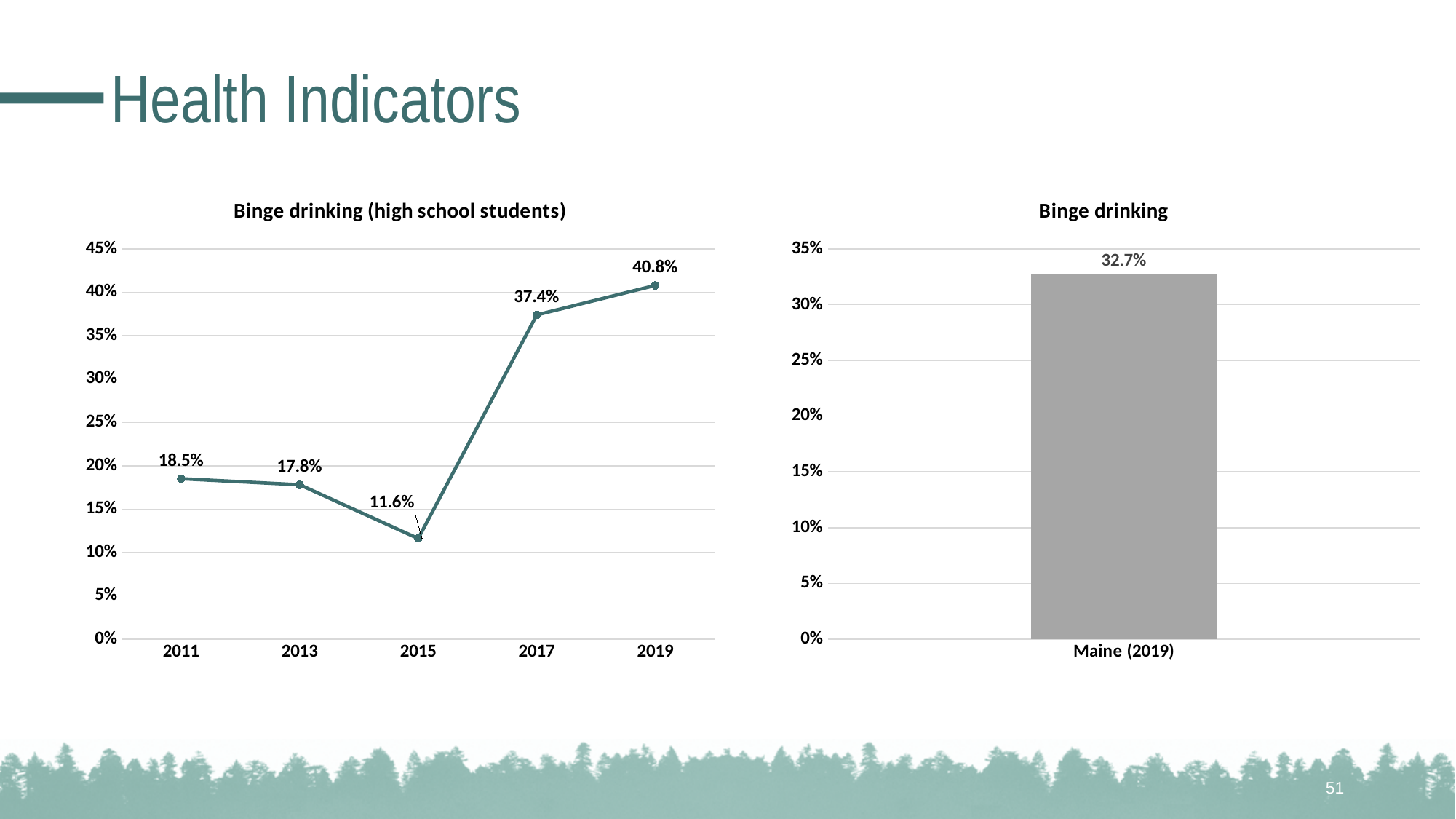
What kind of chart is the 'Binge drinking' chart on the right? Bar chart In the 'Binge drinking (high school students)' chart, which is larger, the value for 2011 or the value for 2013? 2011 What kind of chart is the 'Binge drinking (high school students)' chart? Line chart In the 'Binge drinking (high school students)' chart, how many years are plotted? 5 In the 'Binge drinking (high school students)' chart, which year has the highest value? 2019 In the 'Binge drinking' chart on the right, what is the value for Maine (2019)? 32.7% In the 'Binge drinking (high school students)' chart, what is the value for 2015? 11.6% In the 'Binge drinking (high school students)' chart, which year has the lowest value? 2015 In the 'Binge drinking (high school students)' chart, do the values rise or fall from 2015 to 2019? Rise In the 'Binge drinking (high school students)' chart, what is the value for 2019? 40.8% In the 'Binge drinking (high school students)' chart, what is the difference between the 2019 and 2017 values? 3.4% In the 'Binge drinking' chart on the right, is the value for Maine (2019) greater or less than 30%? greater